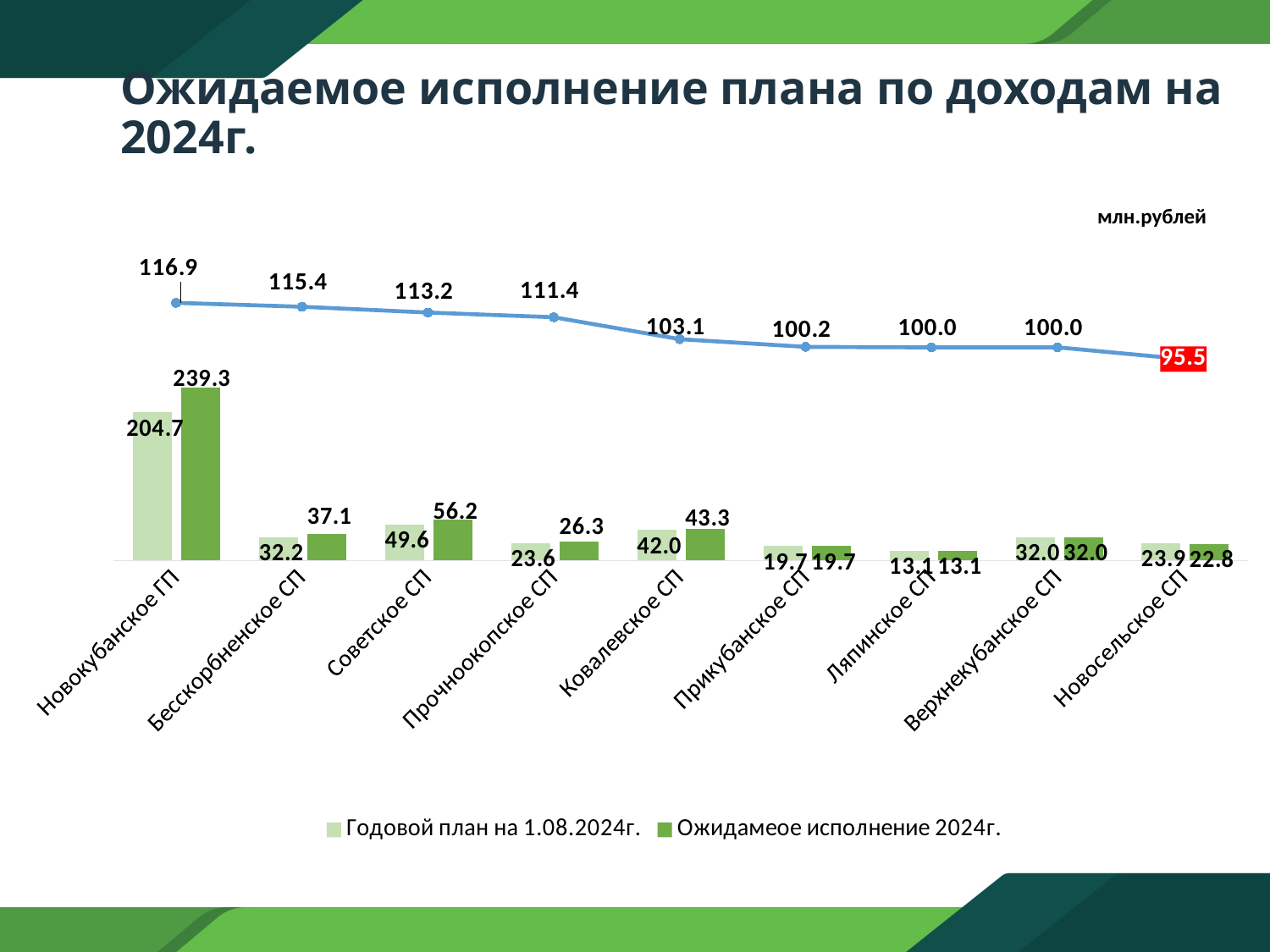
What is the difference between 'Ожидамеое исполнение 2024г.' and 'Годовой план на 1.08.2024г.' for Советское СП? 6.6 Which category has the lowest value of 'Ожидамеое исполнение 2024г.'? Ляпинское СП Which category has the highest value of 'Годовой план на 1.08.2024г.'? Новокубанское ГП What is the value of 'Годовой план на 1.08.2024г.' for Советское СП? 49.6 Do the values of the line rise or fall from left to right along the x axis? fall What is the value of the line data point above Ковалевское СП? 103.1 How many series does the legend list? 2 Which is larger for Новосельское СП: 'Годовой план на 1.08.2024г.' or 'Ожидамеое исполнение 2024г.'? Годовой план на 1.08.2024г. What is the value of 'Ожидамеое исполнение 2024г.' for Новосельское СП? 22.8 How many categories are shown on the x axis? 9 What is the value of 'Ожидамеое исполнение 2024г.' for Новокубанское ГП? 239.3 What is the difference between 'Ожидамеое исполнение 2024г.' and 'Годовой план на 1.08.2024г.' for Новокубанское ГП? 34.6